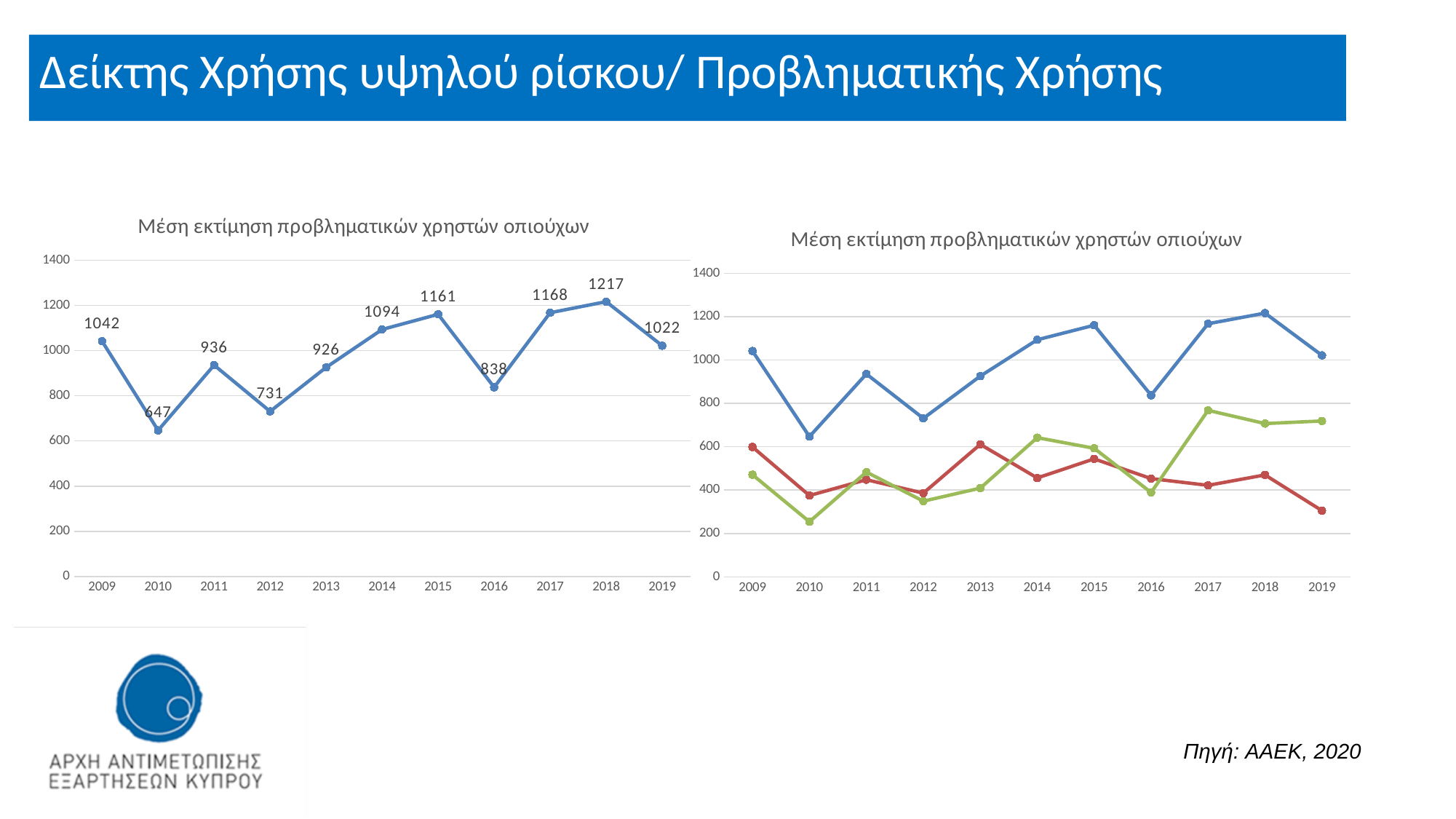
On the left chart, which year has the highest value? 2018 On the right chart, how many lines are plotted? 3 On the left chart, what is the value for 2018? 1217 On the left chart, what is the difference between the values for 2018 and 2019? 195 What kind of chart is the left chart? line chart On the left chart, which is larger, the value for 2011 or the value for 2013? 2011 On the right chart, is the value of the red line for 2019 greater or less than 400? less On the right chart, is the value of the green line for 2010 greater or less than 400? less On the left chart, do the values rise or fall from 2016 to 2018? rise On the left chart, how many years are plotted? 11 On the left chart, which year has the lowest value? 2010 On the left chart, what is the value for 2010? 647